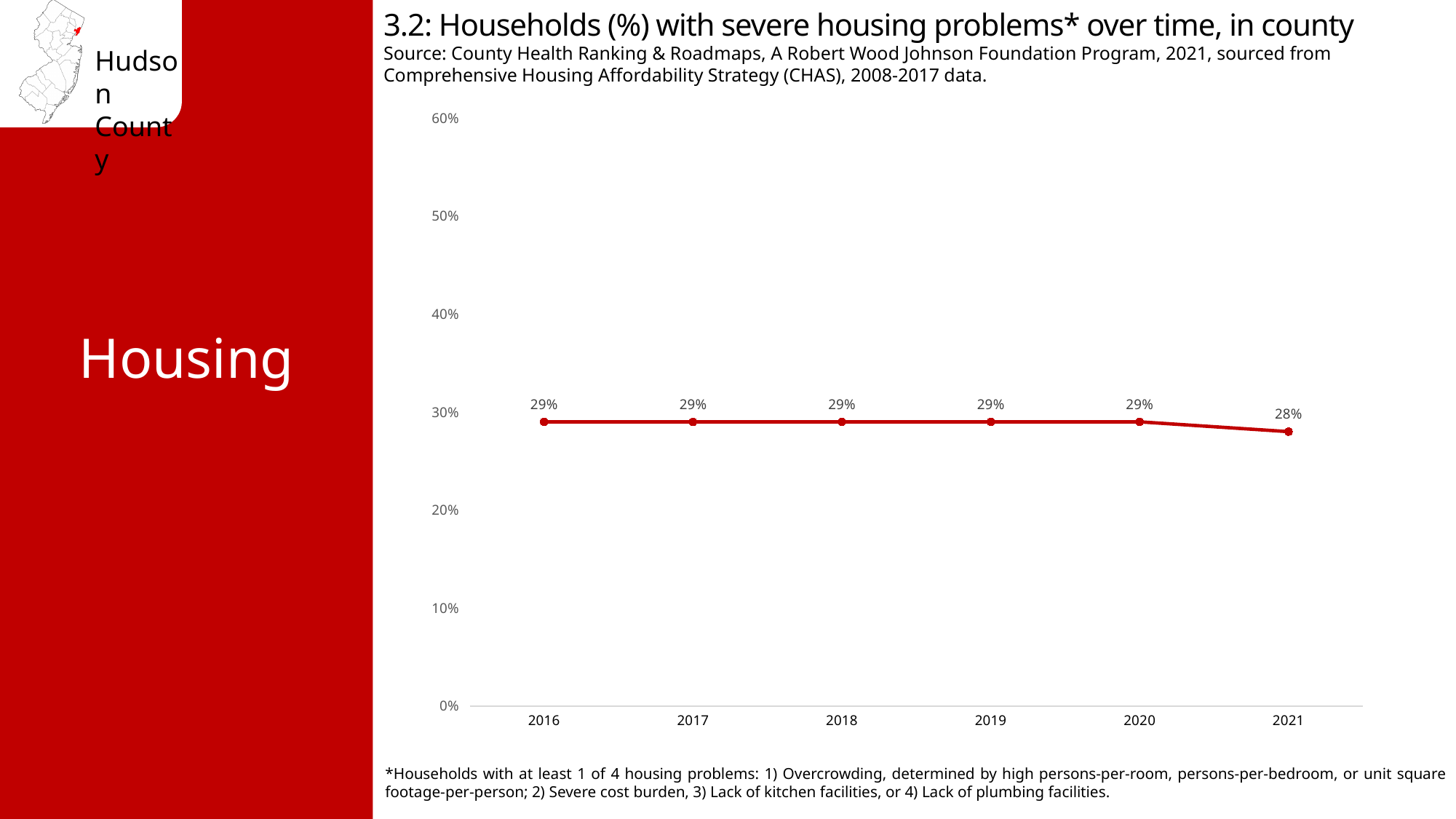
What is the value for 2016? 29% What is the highest value shown on the y axis? 60% What is the difference between the values for 2020 and 2021? 1% How many years are plotted on the chart? 6 Which is larger, the value for 2018 or the value for 2021? 2018 What is the value for 2019? 29% Is the value for 2017 greater or less than 40%? less Do the values rise, fall, or stay flat from 2016 to 2020? stay flat What kind of chart is shown on the slide? line chart What is the value for 2021? 28% Which year has the lowest value? 2021 What is the title of the chart? 3.2: Households (%) with severe housing problems* over time, in county